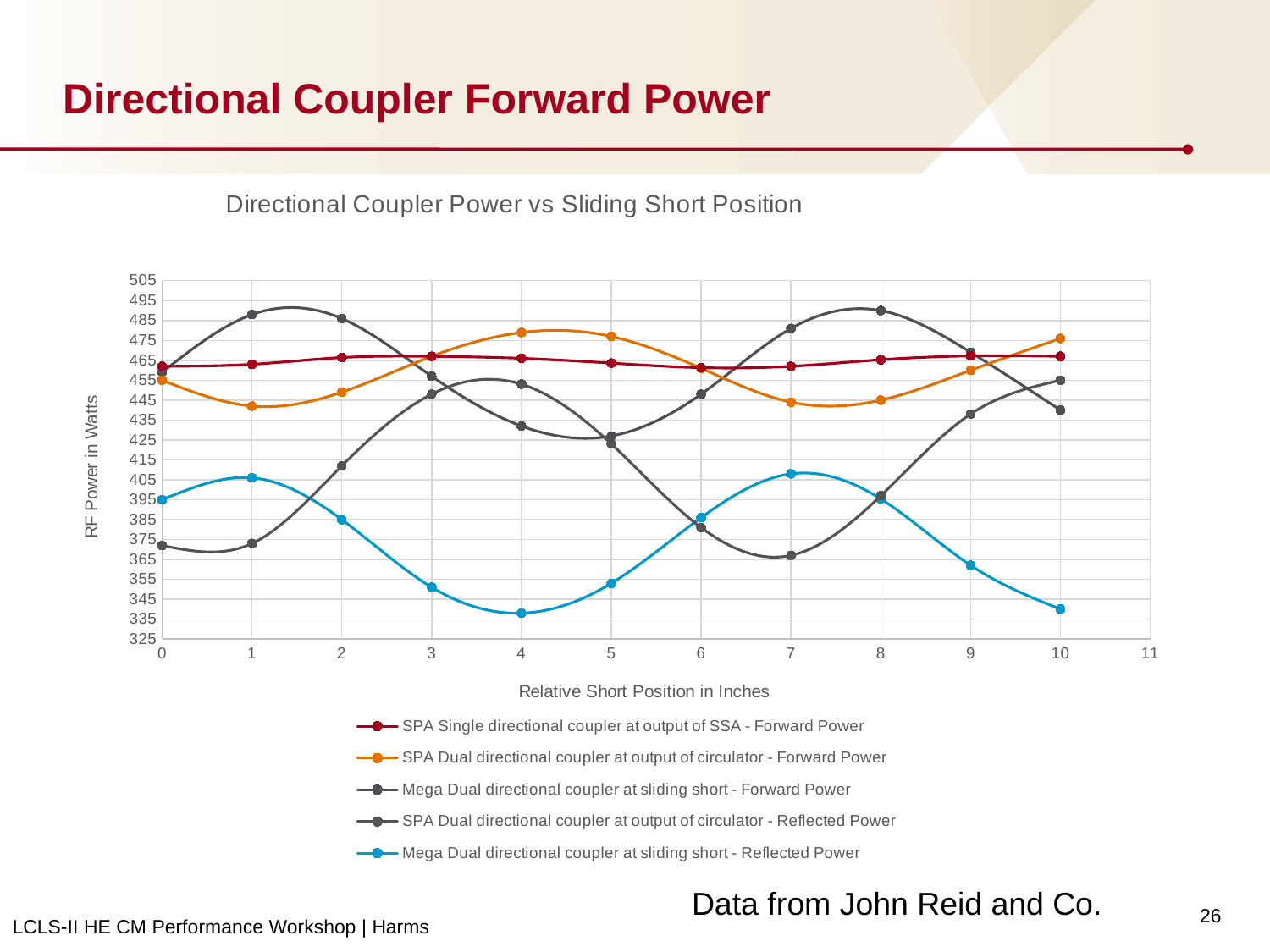
Is the value for SPA Dual directional coupler at output of circulator - Forward Power at position 4 greater or less than 465? greater What is the label of the y axis? RF Power in Watts At position 5, which is larger: SPA Single directional coupler at output of SSA - Forward Power or Mega Dual directional coupler at sliding short - Reflected Power? SPA Single directional coupler at output of SSA - Forward Power Does the Mega Dual directional coupler at sliding short - Reflected Power series rise or fall between positions 1 and 4? fall How many series does the legend list? 5 Is the value for SPA Dual directional coupler at output of circulator - Forward Power at position 1 greater or less than 455? less Is the value for Mega Dual directional coupler at sliding short - Reflected Power at position 7 greater or less than 395? greater What kind of chart is shown on the slide? Line chart What is the title of the chart? Directional Coupler Power vs Sliding Short Position At position 1, which is larger: SPA Single directional coupler at output of SSA - Forward Power or SPA Dual directional coupler at output of circulator - Forward Power? SPA Single directional coupler at output of SSA - Forward Power How many data points are plotted for each series along the x axis? 11